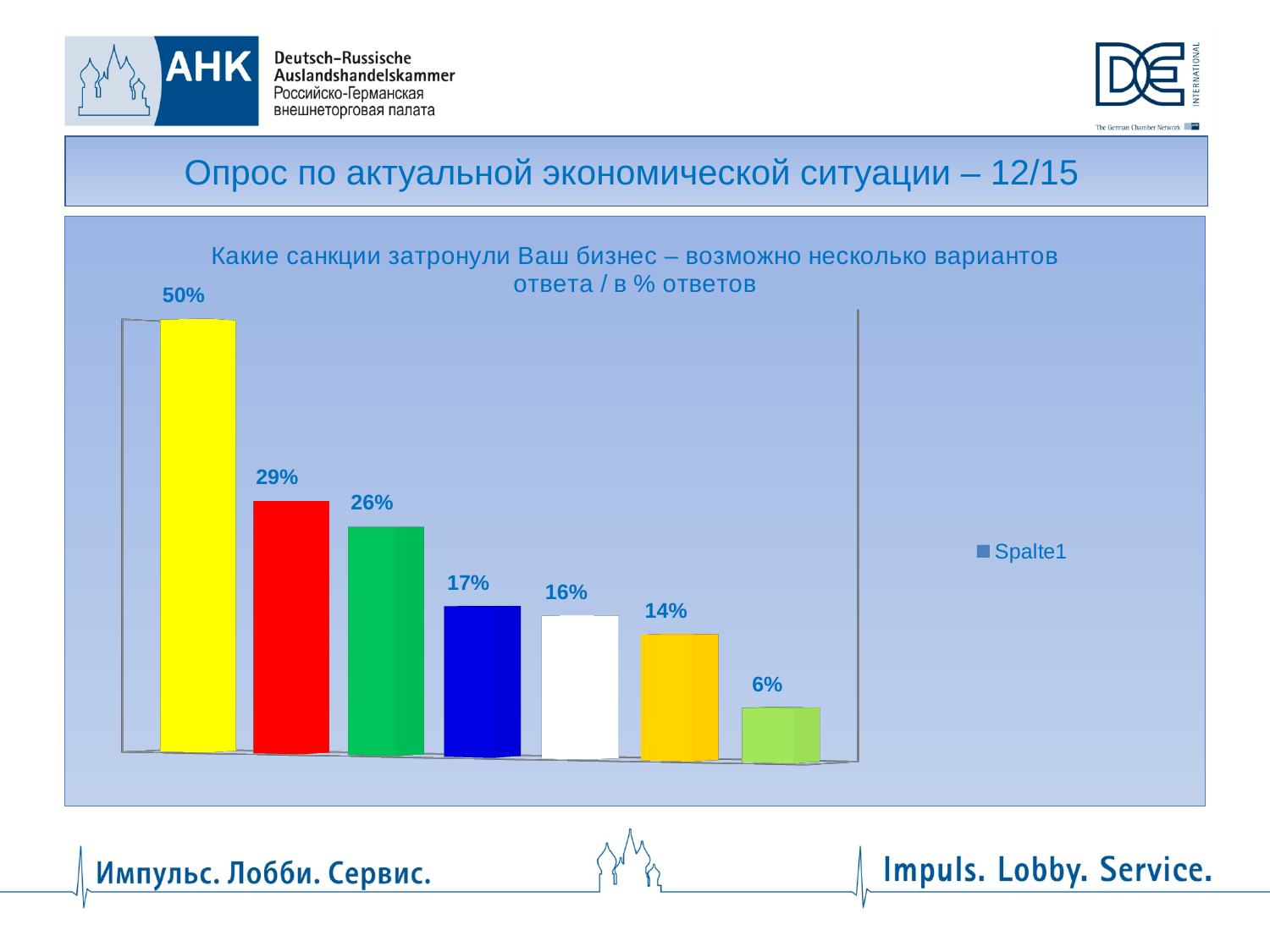
What is the value shown on the red (second) bar? 29% Which is larger, the green (third) bar or the white (fifth) bar? the green (third) bar, 26% What is the value shown on the dark blue (fourth) bar? 17% Which bar has the lowest value? the light green (last) bar, 6% What kind of chart is shown on the slide? bar chart What is the difference between the yellow bar (50%) and the red bar (29%)? 21% What is the legend entry shown on the chart? Spalte1 What is the value shown on the light green (last) bar? 6% What is the value shown on the yellow (first) bar? 50% How many series does the legend list? 1 How many bars does the chart show? 7 Which bar has the highest value? the yellow (first) bar, 50%